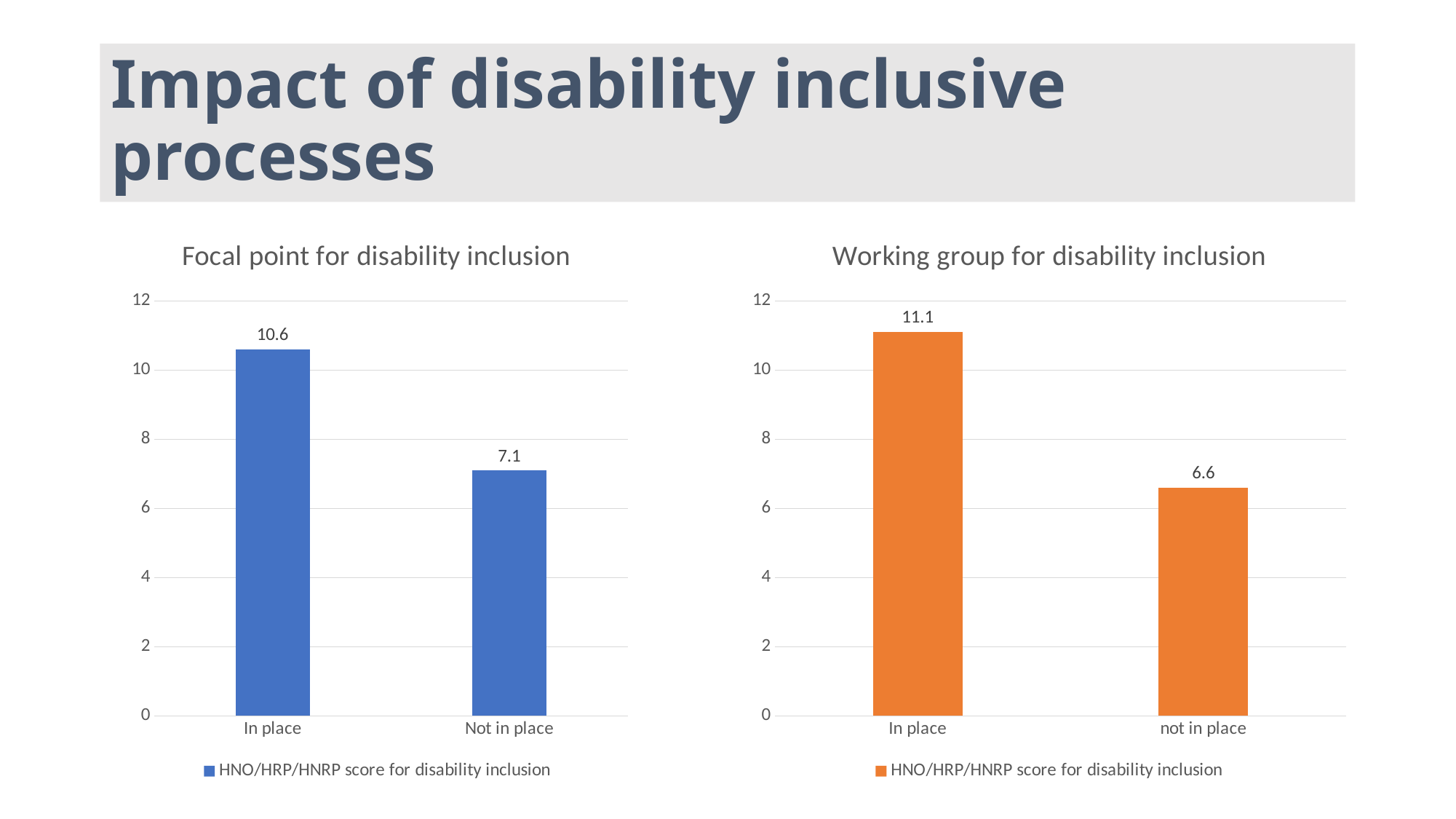
In the 'Focal point for disability inclusion' chart, which category has the highest value? In place What series does the legend of the 'Working group for disability inclusion' chart list? HNO/HRP/HNRP score for disability inclusion In the 'Working group for disability inclusion' chart, which category has the lowest value? not in place In the 'Working group for disability inclusion' chart, what is the difference between the 'In place' and 'not in place' values? 4.5 In the 'Working group for disability inclusion' chart, what is the value for 'not in place'? 6.6 In the 'Working group for disability inclusion' chart, what is the value for 'In place'? 11.1 In the 'Focal point for disability inclusion' chart, what is the difference between the 'In place' and 'Not in place' values? 3.5 In the 'Focal point for disability inclusion' chart, what is the value for 'Not in place'? 7.1 What type of chart is the 'Focal point for disability inclusion' chart? Bar chart How many categories are shown in the 'Working group for disability inclusion' chart? 2 Which is larger: the 'In place' value in the 'Focal point for disability inclusion' chart or the 'In place' value in the 'Working group for disability inclusion' chart? Working group for disability inclusion In the 'Focal point for disability inclusion' chart, what is the value for 'In place'? 10.6